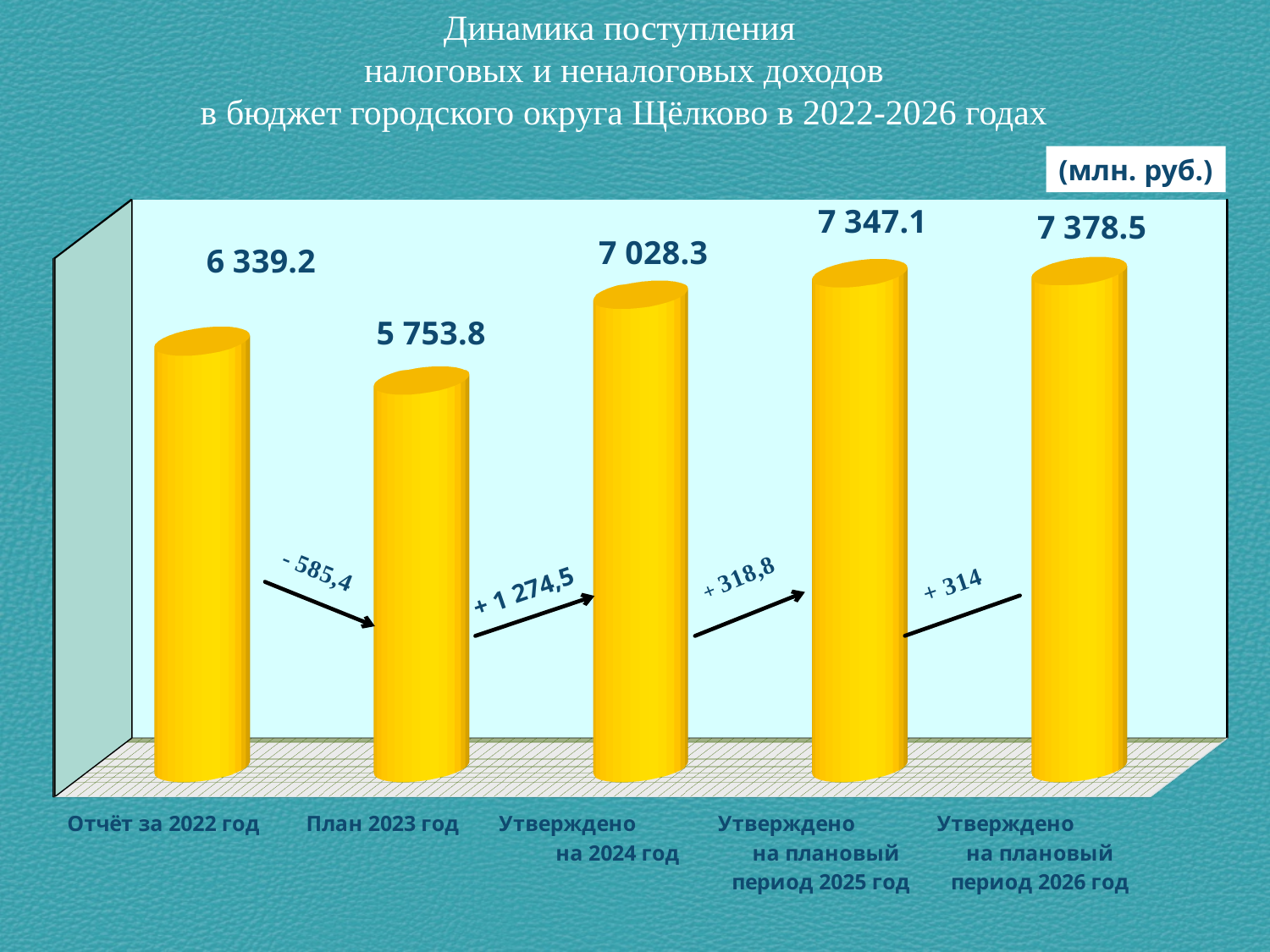
What is the value for План 2023 год? 5 753.8 What is the value for Утверждено на 2024 год? 7 028.3 What is the difference between the values for Утверждено на 2024 год and Утверждено на плановый период 2025 год? 318.8 Which category has the highest value? Утверждено на плановый период 2026 год What kind of chart is shown on the slide? Bar chart How many bars are shown in the chart? 5 Which is larger, the value for Отчёт за 2022 год or the value for Утверждено на 2024 год? Утверждено на 2024 год What is the value for Отчёт за 2022 год? 6 339.2 In what units are the values on the chart given? млн. руб. What is the difference between the values for Отчёт за 2022 год and План 2023 год? 585.4 Which category has the lowest value? План 2023 год What is the value for Утверждено на плановый период 2026 год? 7 378.5